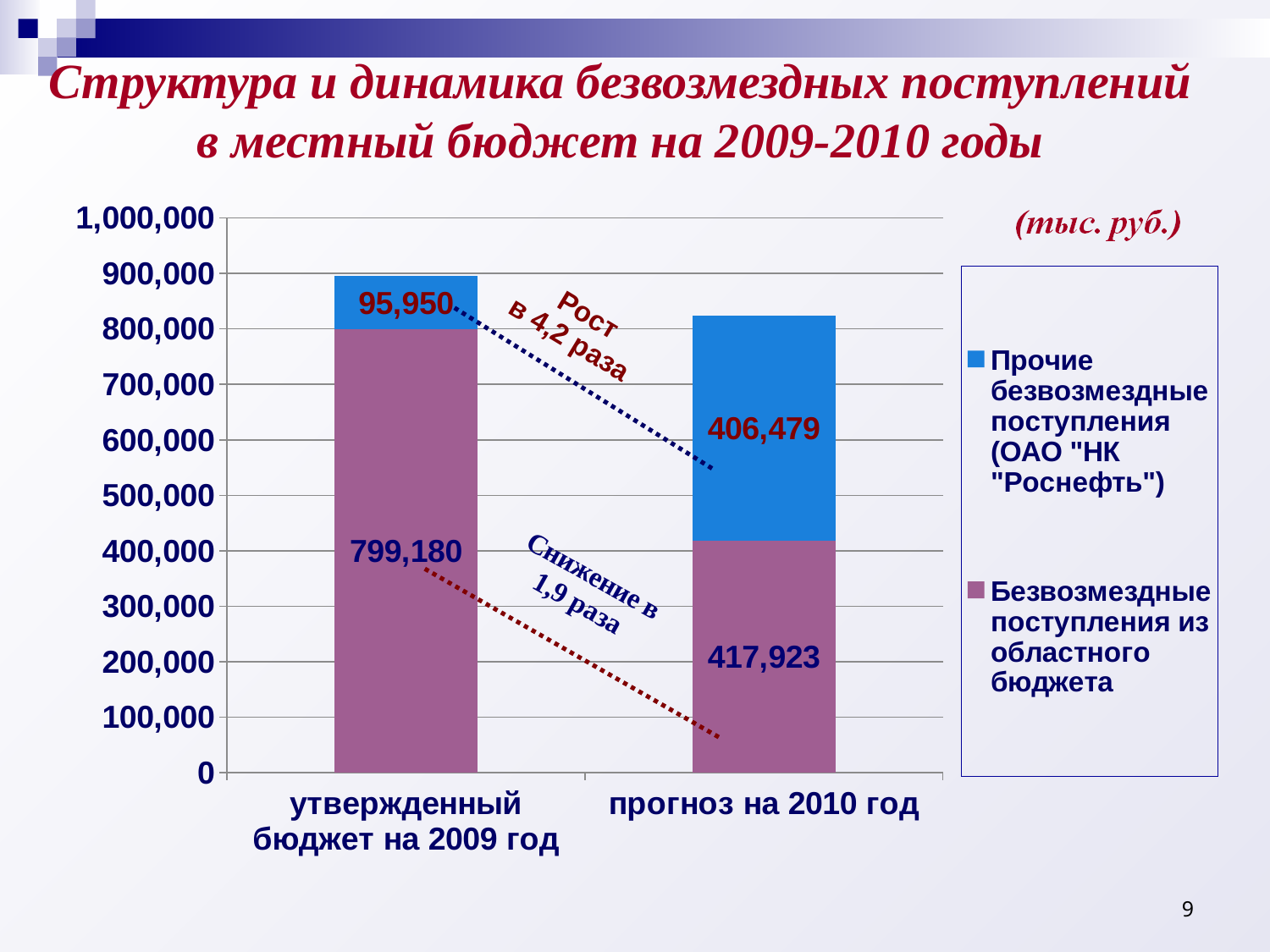
How many categories are shown on the x axis? 2 What is the value of "Прочие безвозмездные поступления (ОАО "НК "Роснефть")" for "утвержденный бюджет на 2009 год"? 95,950 Which category has the larger value for "Прочие безвозмездные поступления (ОАО "НК "Роснефть")"? прогноз на 2010 год What is the total of the stacked bar for "утвержденный бюджет на 2009 год"? 895,130 What unit is indicated next to the chart? (тыс. руб.) What is the value of "Прочие безвозмездные поступления (ОАО "НК "Роснефть")" for "прогноз на 2010 год"? 406,479 Does the value of "Безвозмездные поступления из областного бюджета" rise or fall from 2009 to the 2010 forecast? Fall How many series does the legend list? 2 What is the value of "Безвозмездные поступления из областного бюджета" for "утвержденный бюджет на 2009 год"? 799,180 What kind of chart is shown on the slide? Stacked bar chart By how much does "Безвозмездные поступления из областного бюджета" decrease from 2009 to the 2010 forecast? 381,257 What is the total of the stacked bar for "прогноз на 2010 год"? 824,402